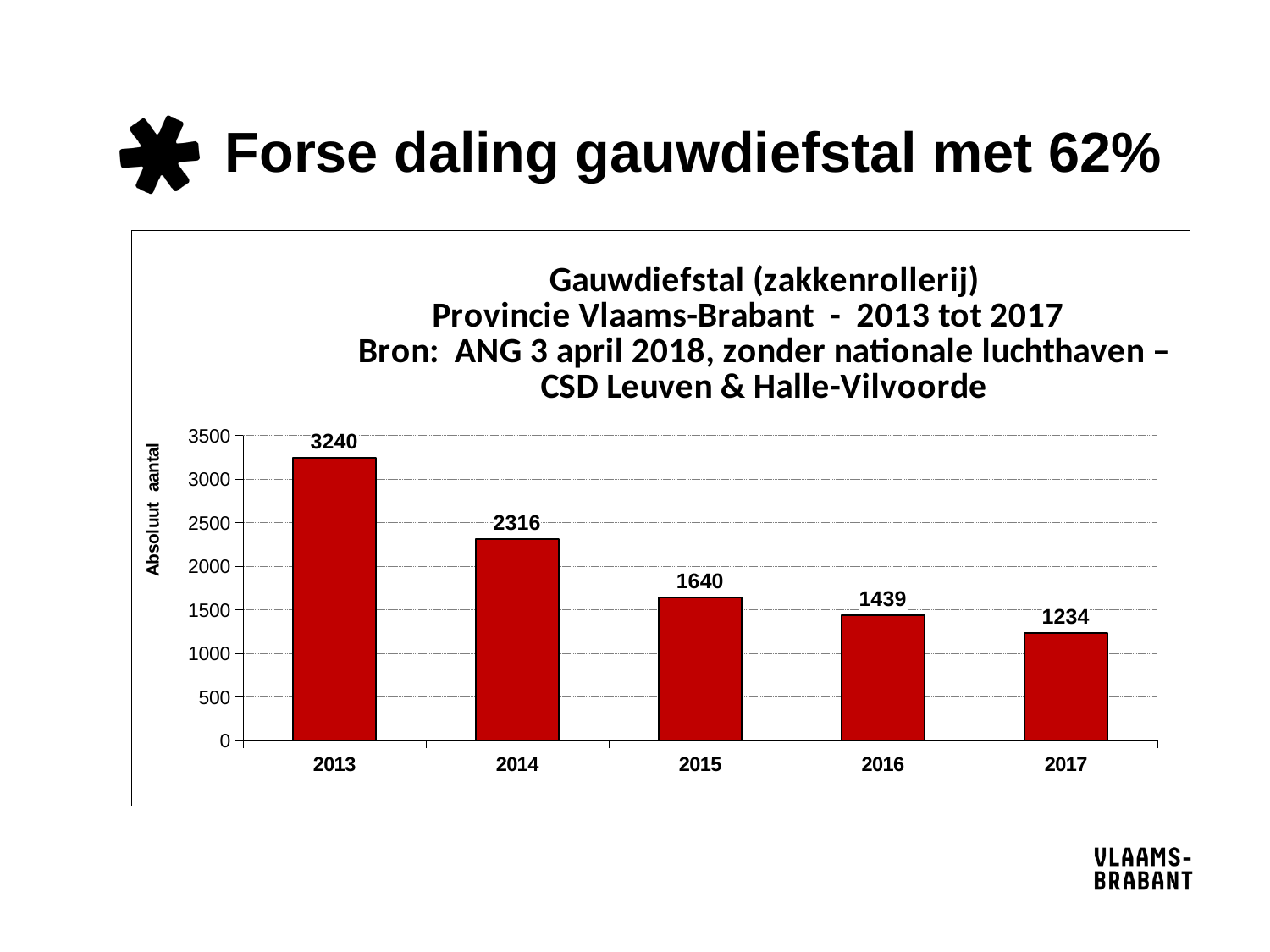
What is the value for 2017? 1234 Which year has the lowest value? 2017 What is the value for 2015? 1640 Is the value for 2016 greater or less than 1500? less What is the value for 2013? 3240 What is the difference between the values for 2016 and 2017? 205 What kind of chart is shown? bar chart Which year has the highest value? 2013 What is the difference between the values for 2013 and 2014? 924 Which is larger, the value for 2014 or the value for 2015? 2014 How many years are shown on the x axis? 5 Do the values rise or fall from 2013 to 2017? fall